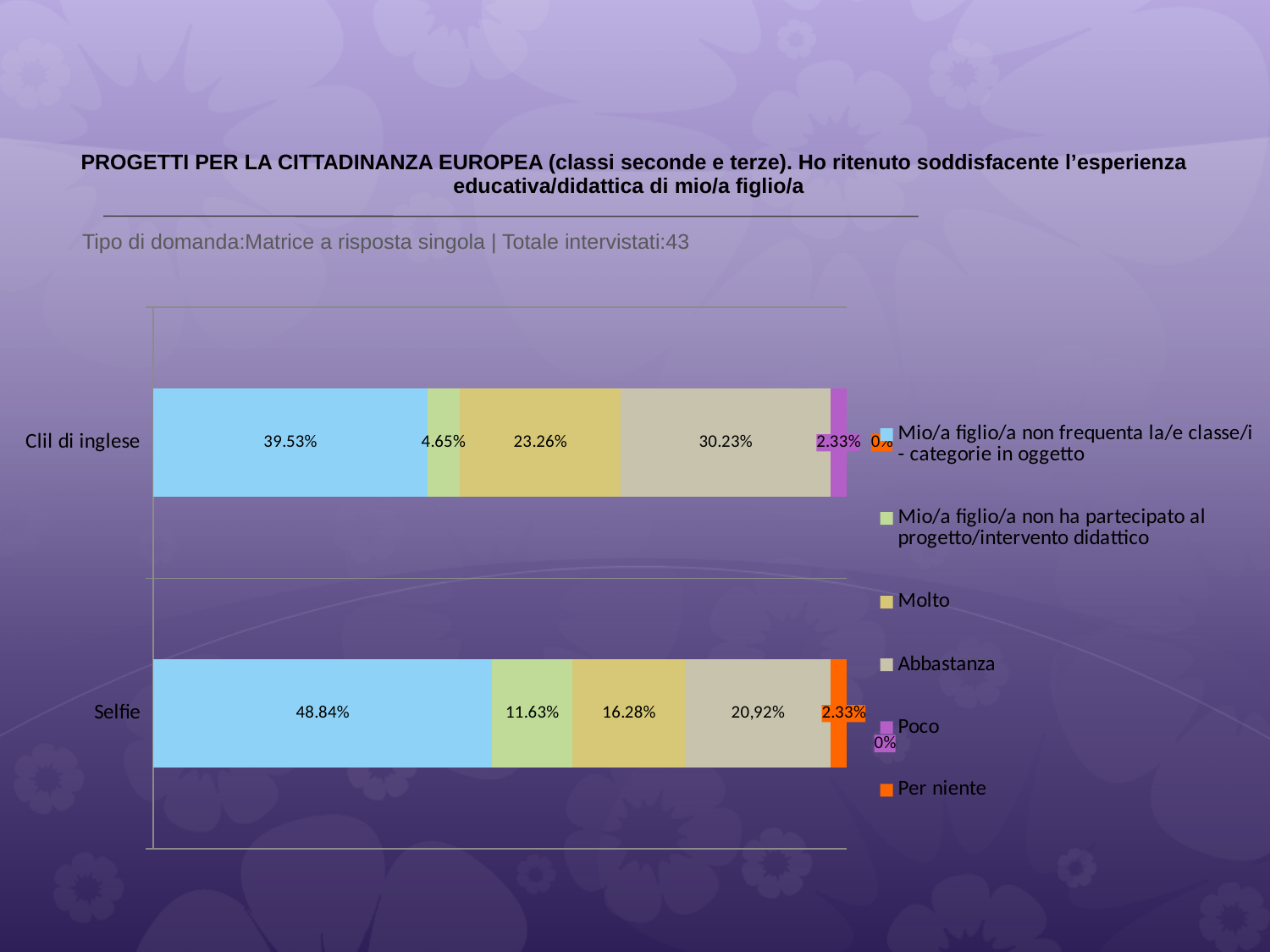
How many series does the legend list? 6 What is the total number of respondents stated on the slide? 43 What is the value of "Mio/a figlio/a non ha partecipato al progetto/intervento didattico" for Selfie? 11.63% Which category has the higher value for "Molto", Clil di inglese or Selfie? Clil di inglese What is the difference between the "Mio/a figlio/a non frequenta la/e classe/i - categorie in oggetto" values for Selfie and Clil di inglese? 9.31% What is the value of "Abbastanza" for Clil di inglese? 30.23% What kind of chart is shown on the slide? Stacked bar chart How many categories (bars) are plotted on the chart? 2 What is the value of "Molto" for Selfie? 16.28% What is the value of "Mio/a figlio/a non frequenta la/e classe/i - categorie in oggetto" for Clil di inglese? 39.53% What is the value of "Per niente" for Selfie? 2.33% Which series has the largest value in the Clil di inglese bar? Mio/a figlio/a non frequenta la/e classe/i - categorie in oggetto